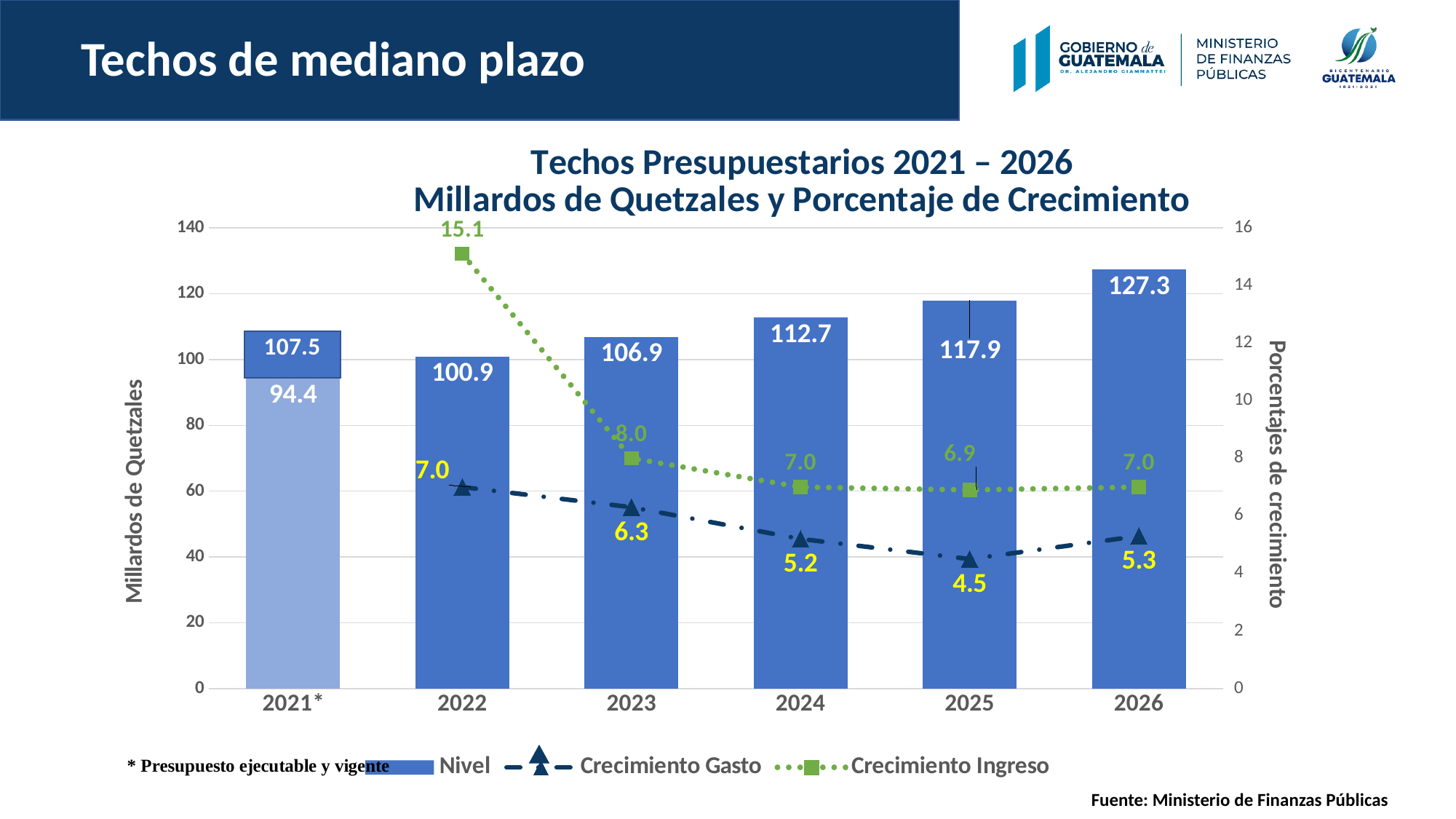
What is the Nivel value for 2024? 112.7 What kind of chart is this? Combined bar and line chart Which is larger, the Crecimiento Ingreso value for 2023 or the Crecimiento Gasto value for 2023? Crecimiento Ingreso (8.0) What is the Nivel value for 2026? 127.3 Which year has the highest Nivel value? 2026 What is the difference between the Nivel values for 2026 and 2025? 9.4 What is the Crecimiento Gasto value for 2025? 4.5 What is the Crecimiento Ingreso value for 2022? 15.1 Which year has the lowest Crecimiento Gasto value? 2025 How many series does the legend list? 3 Does the Crecimiento Ingreso series rise or fall from 2022 to 2025? Fall How many years are shown on the x axis? 6